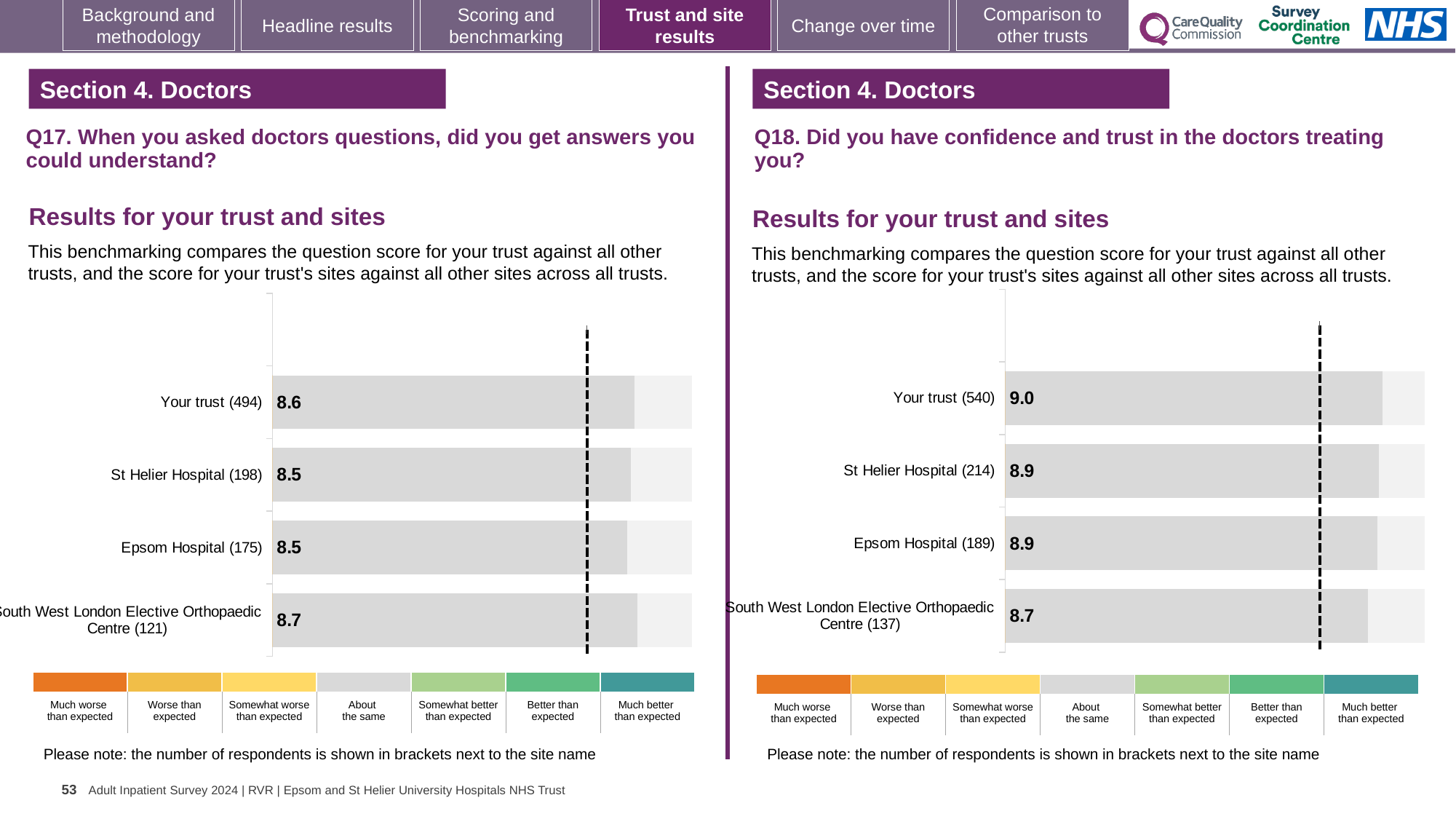
In the Q17 chart on the left, what is the score for South West London Elective Orthopaedic Centre? 8.7 In the Q18 chart on the right, which has the larger score: Your trust or St Helier Hospital? Your trust In the Q17 chart on the left, which site or trust has the highest score? South West London Elective Orthopaedic Centre In the Q17 chart on the left, how many respondents are shown in brackets for Your trust? 494 What kind of chart is used for the Q18 results on the right? Bar chart In the Q18 chart on the right, which site or trust has the lowest score? South West London Elective Orthopaedic Centre In the Q17 chart on the left, what is the score for Your trust? 8.6 In the Q18 chart on the right, what is the score for Epsom Hospital? 8.9 In the Q17 chart on the left, what is the difference between the score for South West London Elective Orthopaedic Centre and the score for St Helier Hospital? 0.2 In the Q18 chart on the right, what is the difference between the score for Your trust and the score for South West London Elective Orthopaedic Centre? 0.3 How many bars are plotted in the Q17 chart on the left? 4 In the Q18 chart on the right, what is the score for Your trust? 9.0